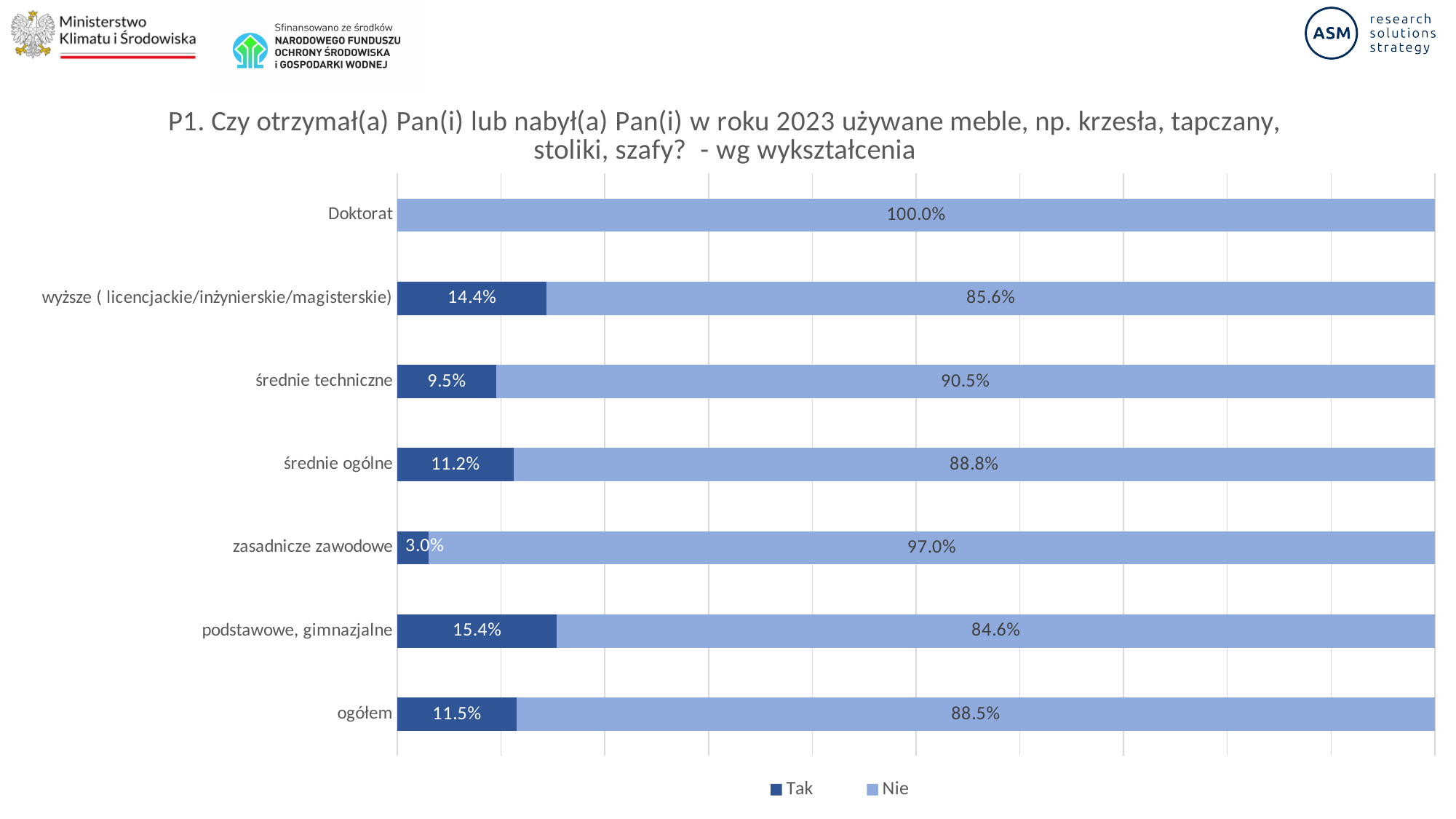
What is the 'Nie' value for 'zasadnicze zawodowe'? 97.0% What is the 'Tak' value for 'średnie techniczne'? 9.5% How many education categories are shown on the chart? 7 What is the 'Tak' value for 'ogółem'? 11.5% Which category has the highest 'Tak' value? podstawowe, gimnazjalne What is the 'Nie' value for 'Doktorat'? 100.0% What kind of chart is shown on the slide? Stacked bar chart Which is larger: the 'Tak' value for 'średnie ogólne' or for 'zasadnicze zawodowe'? średnie ogólne What is the difference between the 'Tak' values for 'wyższe ( licencjackie/inżynierskie/magisterskie)' and 'średnie techniczne'? 4.9 percentage points Which category has the lowest 'Nie' value? podstawowe, gimnazjalne How many series does the legend list? 2 What is the total of the stacked bar for 'podstawowe, gimnazjalne'? 100.0%